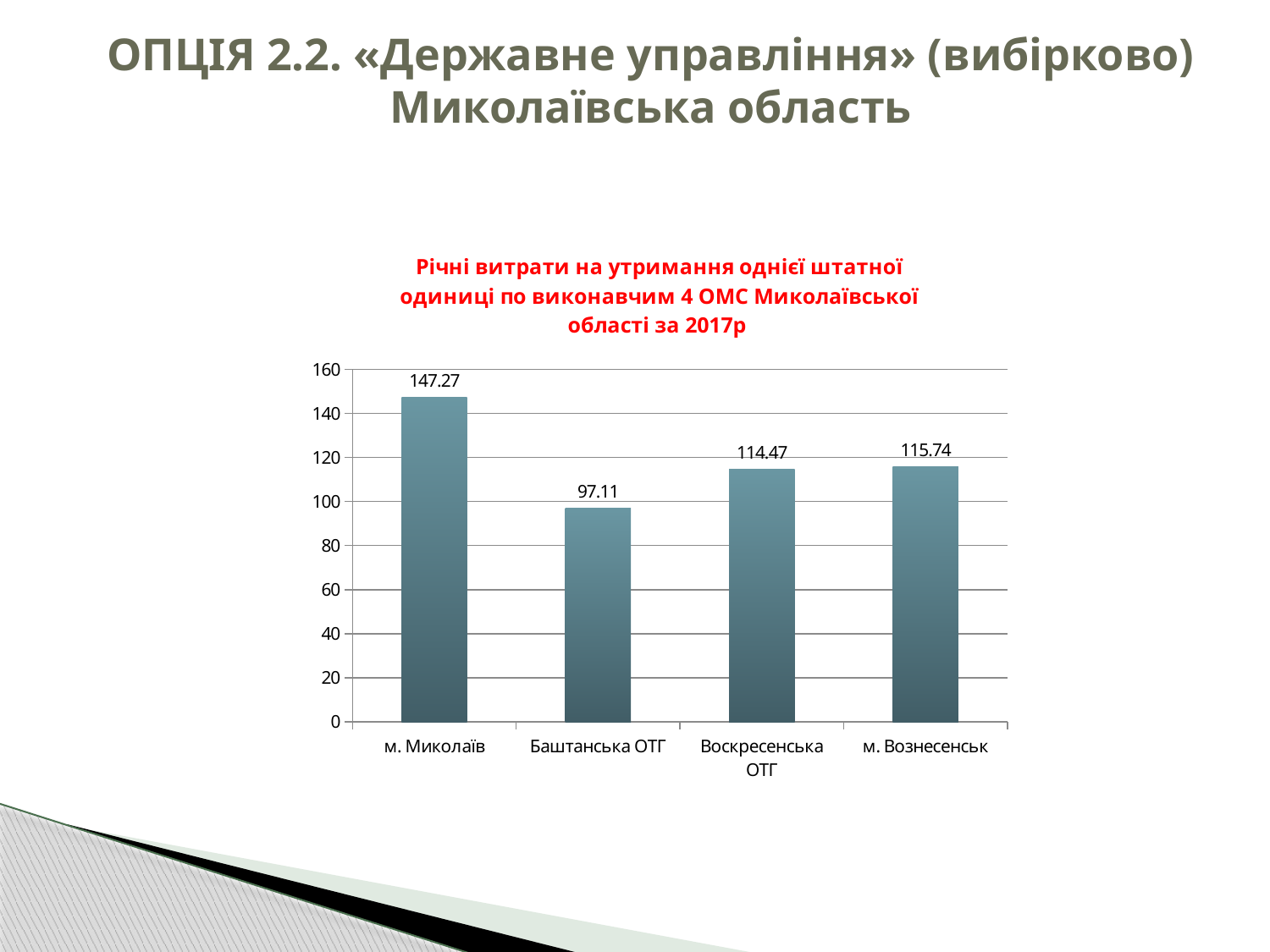
How many categories are shown on the x axis? 4 Is the value for Баштанська ОТГ greater or less than 100? less Which category has the highest value? м. Миколаїв Which is larger, the value for м. Вознесенськ or the value for Воскресенська ОТГ? м. Вознесенськ What is the value for Баштанська ОТГ? 97.11 What kind of chart is shown on the slide? bar chart What is the difference between the values for м. Вознесенськ and Воскресенська ОТГ? 1.27 What is the value for м. Вознесенськ? 115.74 What is the value for Воскресенська ОТГ? 114.47 What is the difference between the values for м. Миколаїв and Баштанська ОТГ? 50.16 Which category has the lowest value? Баштанська ОТГ What is the value for м. Миколаїв? 147.27